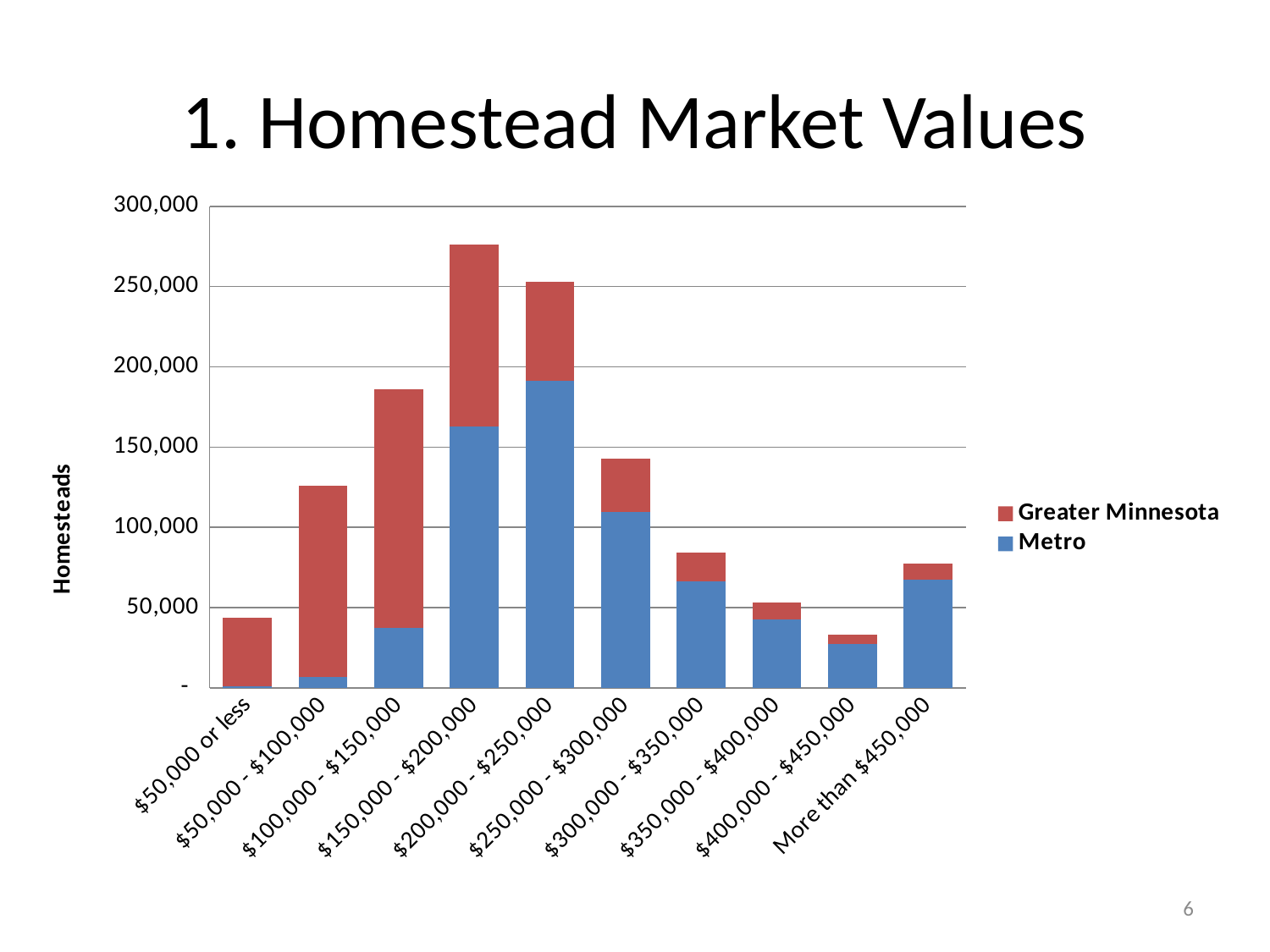
Which series is shown in red in the legend? Greater Minnesota Which market value category has the shortest stacked bar overall? $400,000 - $450,000 Is the total number of homesteads for $50,000 or less greater or less than 50,000? less Which market value category has the largest Metro segment? $200,000 - $250,000 Is the total number of homesteads for $150,000 - $200,000 greater or less than 250,000? greater How many market value categories are shown on the x axis? 10 How many series does the legend list? 2 Which has a larger total bar: $150,000 - $200,000 or $200,000 - $250,000? $150,000 - $200,000 Which market value category has the tallest stacked bar overall? $150,000 - $200,000 Do the total bar heights rise or fall from $200,000 - $250,000 through $400,000 - $450,000? Fall What kind of chart is shown on the slide? Stacked bar chart Is the Metro value for $200,000 - $250,000 greater or less than 150,000? greater